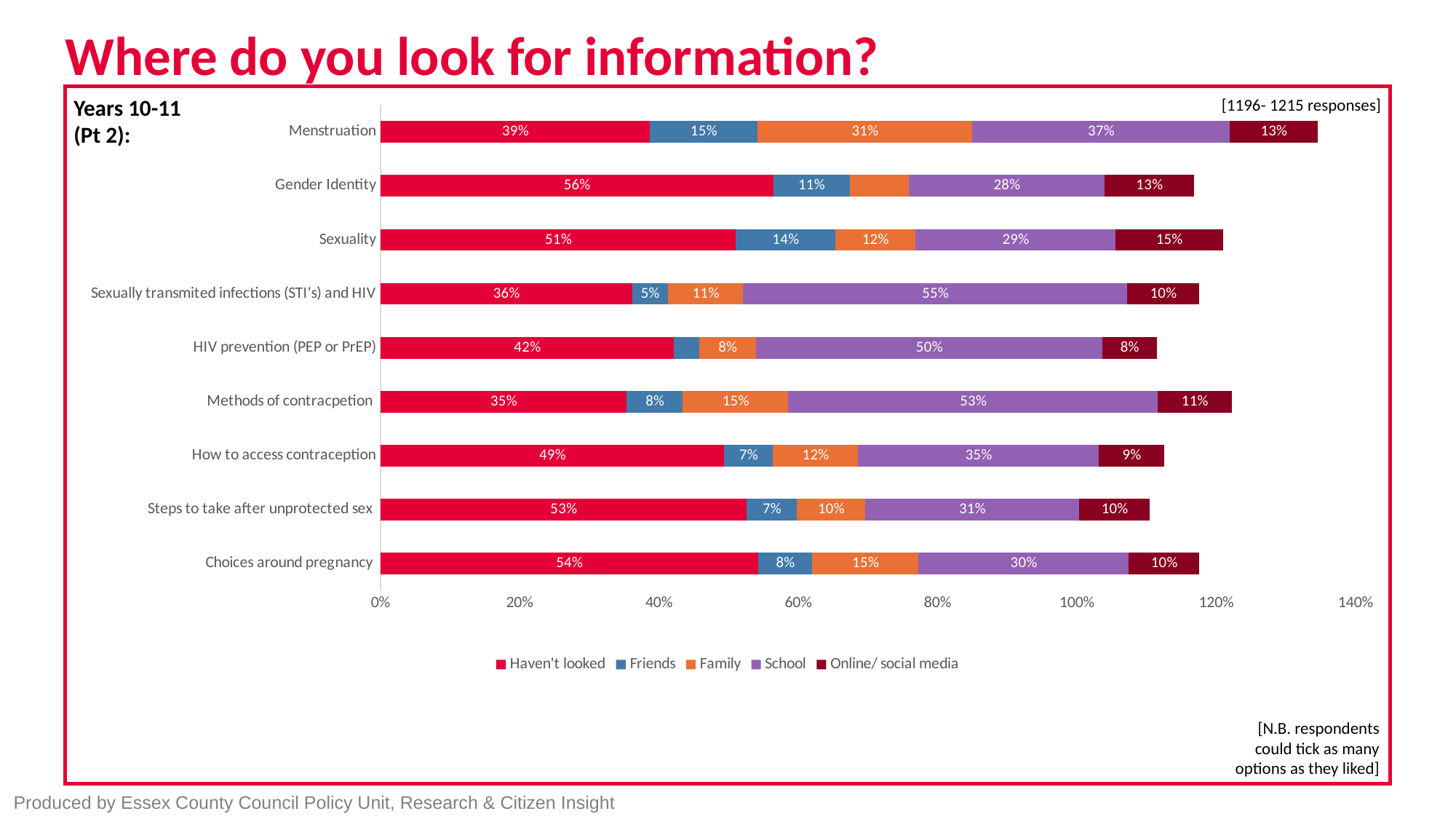
Which topic has the lowest 'Haven't looked' value? Methods of contracpetion How many series does the legend list? 5 What is the 'Haven't looked' value for Gender Identity? 56% What kind of chart is shown on the slide? Stacked bar chart How many topic categories are plotted on the chart? 9 Which is larger: the Friends value for Menstruation or the Friends value for Sexuality? Menstruation What is the difference between the School values for HIV prevention (PEP or PrEP) and Choices around pregnancy? 20% What is the School value for Sexually transmited infections (STI's) and HIV? 55% What is the Family value for Menstruation? 31% What is the total of the stacked bar for Sexuality? 121% Which topic has the highest 'Haven't looked' value? Gender Identity Which topic has the highest Online/ social media value? Sexuality